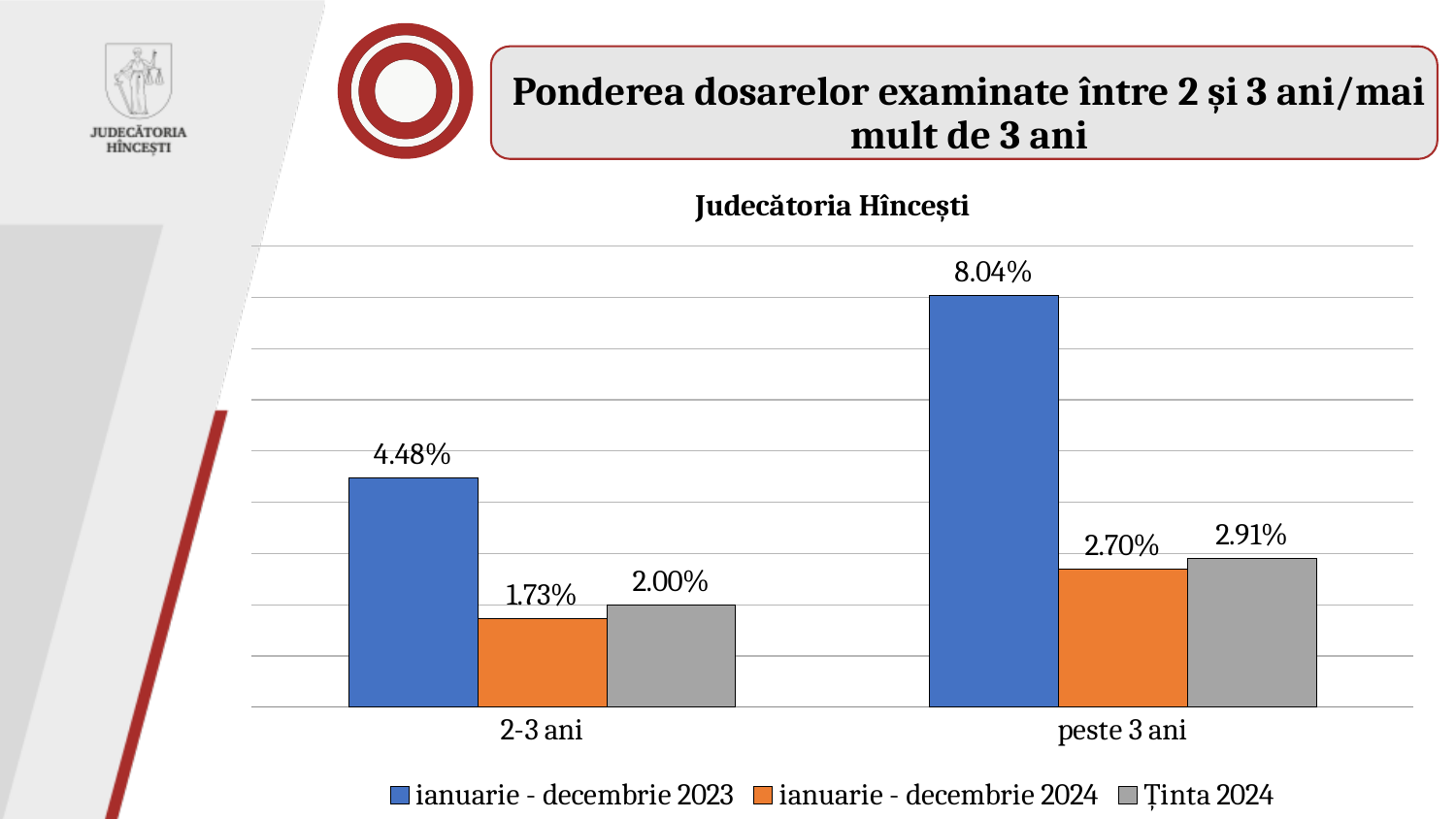
What is the difference between the 'ianuarie - decembrie 2023' and 'ianuarie - decembrie 2024' values in the 'peste 3 ani' category? 5.34% Which is larger: the 'ianuarie - decembrie 2024' value for '2-3 ani' or for 'peste 3 ani'? peste 3 ani What is the value for 'ianuarie - decembrie 2024' in the 'peste 3 ani' category? 2.70% How many series does the legend list? 3 Which series has the highest value in the 'peste 3 ani' category? ianuarie - decembrie 2023 What kind of chart is shown on the slide? bar chart How many categories are shown on the x axis? 2 What is the value for 'Ținta 2024' in the '2-3 ani' category? 2.00% What is the value for 'ianuarie - decembrie 2023' in the 'peste 3 ani' category? 8.04% What is the value for 'ianuarie - decembrie 2023' in the '2-3 ani' category? 4.48% Which series has the lowest value in the '2-3 ani' category? ianuarie - decembrie 2024 What is the difference between the 'Ținta 2024' and 'ianuarie - decembrie 2024' values in the '2-3 ani' category? 0.27%